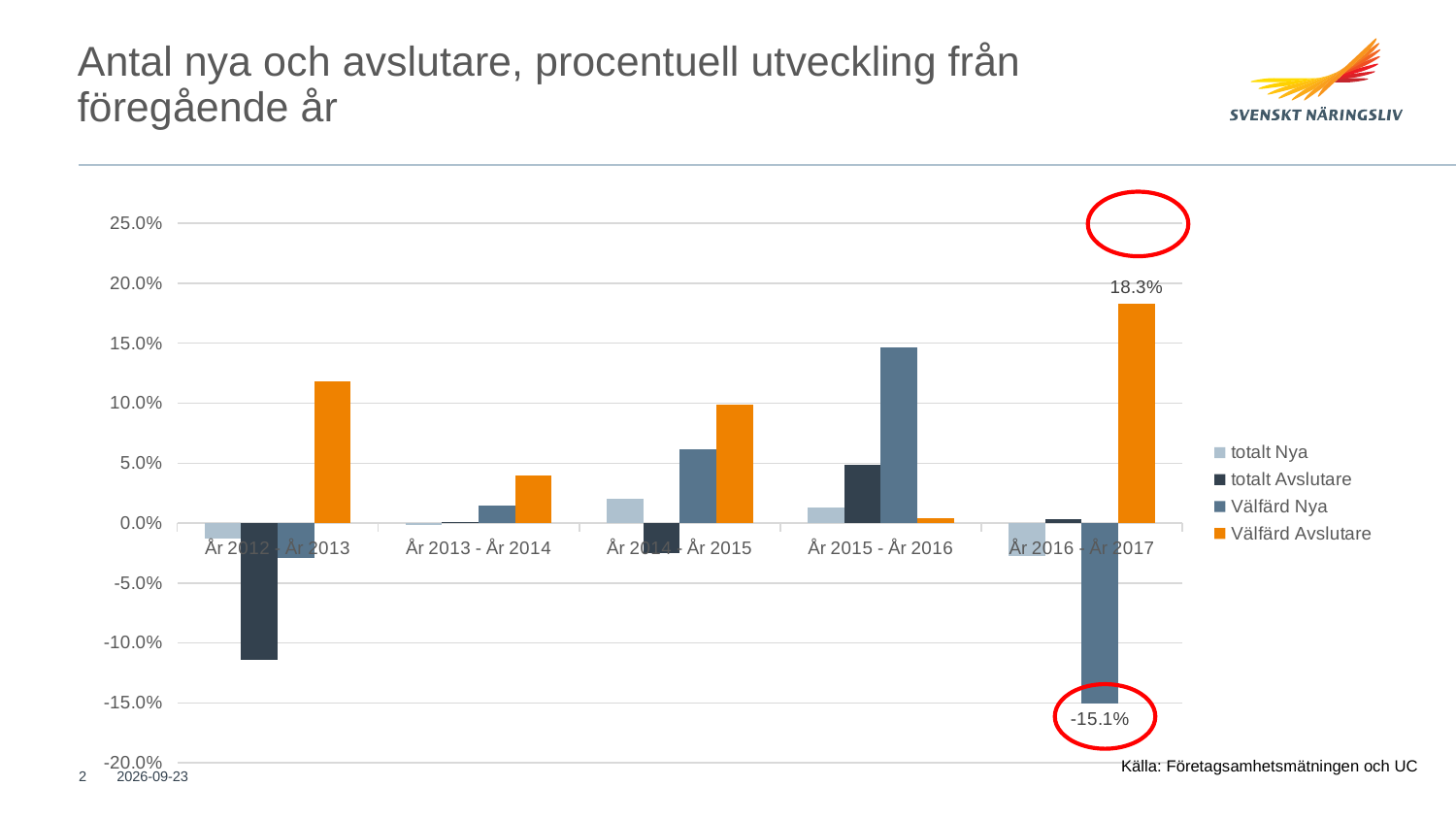
How many series does the legend list? 4 What kind of chart is shown on the slide? Bar chart In År 2015 - År 2016, which is larger: Välfärd Nya or Välfärd Avslutare? Välfärd Nya Is the value for Välfärd Avslutare in År 2014 - År 2015 greater or less than 5.0%? greater What is the value for Välfärd Avslutare in År 2016 - År 2017? 18.3% Is the value for totalt Avslutare in År 2012 - År 2013 greater or less than -10.0%? less How many year-to-year periods are shown on the x axis? 5 In which period is the Välfärd Nya bar lowest? År 2016 - År 2017 In which period is the Välfärd Avslutare bar highest? År 2016 - År 2017 Is the value for Välfärd Nya in År 2015 - År 2016 greater or less than 10.0%? greater What is the value for Välfärd Nya in År 2016 - År 2017? -15.1% In År 2016 - År 2017, what is the difference between the Välfärd Avslutare value and the Välfärd Nya value? 33.4 percentage points